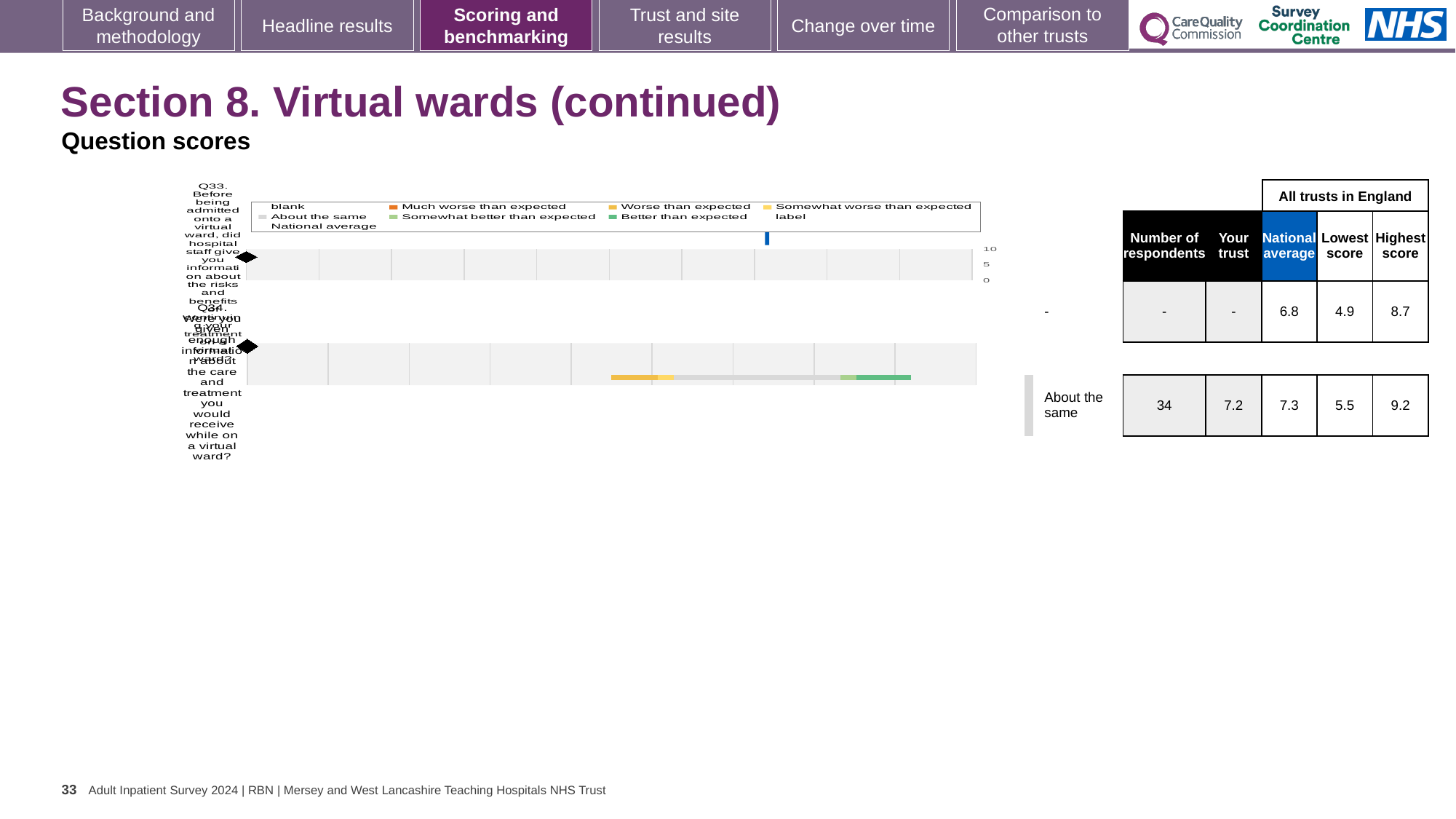
Which colour does the legend use for 'Better than expected'? green For Q34, which is larger: the 'Your trust' score or the national average? National average What is the difference between the highest score and the lowest score for Q33? 3.8 In the table beside the chart, how many respondents are recorded for Q34? 34 In the table beside the chart, what is the national average for Q33? 6.8 What is the difference between the highest score and the lowest score for Q34? 3.7 What is the highest value shown on the chart's axis? 10 In the table beside the chart, what is the national average for Q34? 7.3 How many questions (categories) are plotted in the chart? 2 What benchmark category is given for Q34 next to the chart? About the same In the table beside the chart, what is the 'Your trust' score for Q34? 7.2 What kind of chart is shown on the slide? bar chart